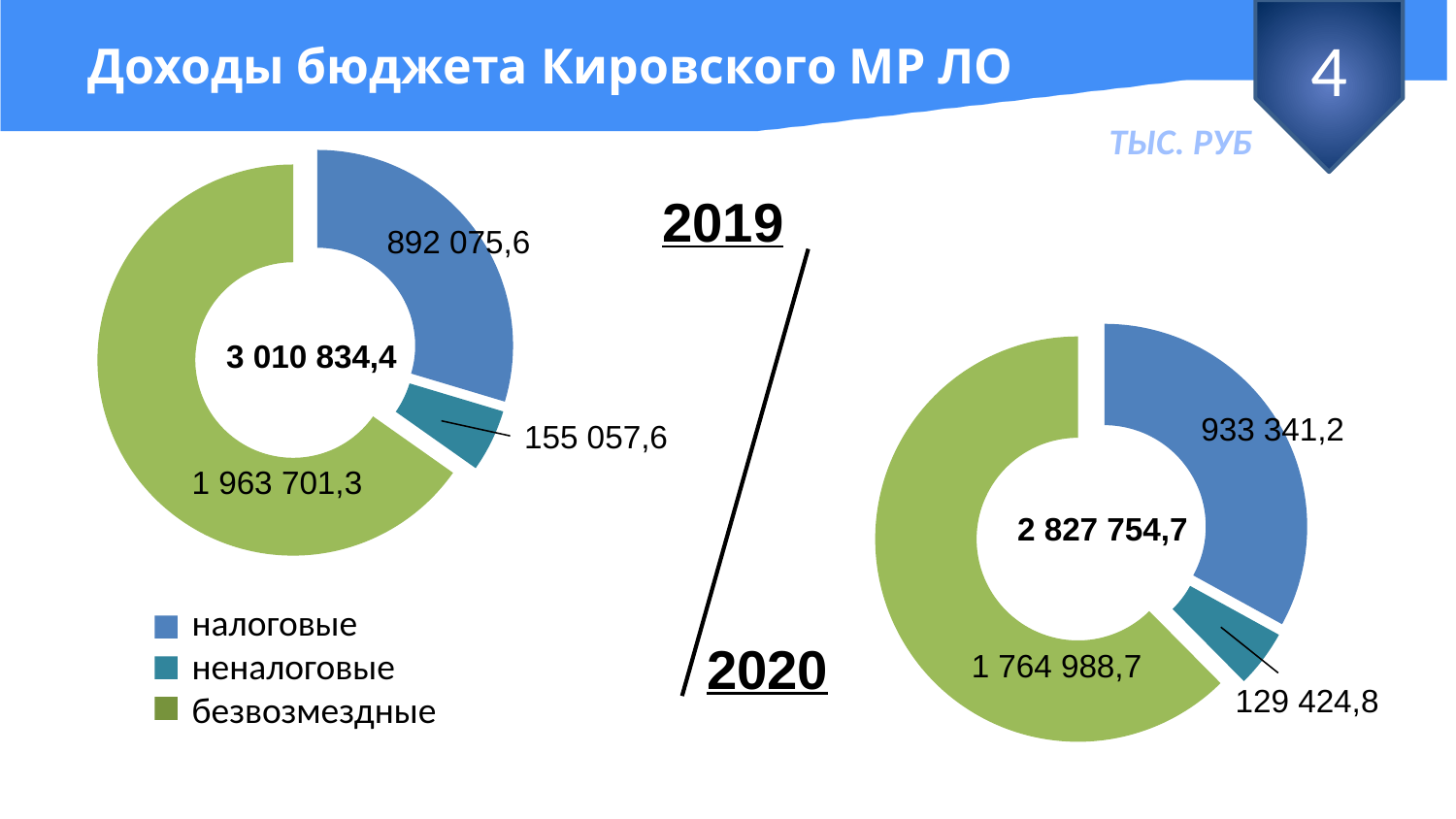
Is the безвозмездные value larger in the 2019 chart or in the 2020 chart? 2019 In the 2020 chart, which category has the smallest value? неналоговые In the 2020 chart, what is the value for неналоговые? 129 424,8 What is the difference between the налоговые value in the 2020 chart and the налоговые value in the 2019 chart? 41 265,6 How many categories does the legend list? 3 In the 2019 chart, what is the value for налоговые? 892 075,6 What is the total shown in the centre of the 2019 chart? 3 010 834,4 In the 2019 chart, which category has the largest value? безвозмездные What is the total shown in the centre of the 2020 chart? 2 827 754,7 In the 2019 chart, what is the value for неналоговые? 155 057,6 In the 2020 chart, what is the value for безвозмездные? 1 764 988,7 What kind of chart is used on this slide? doughnut (pie) chart